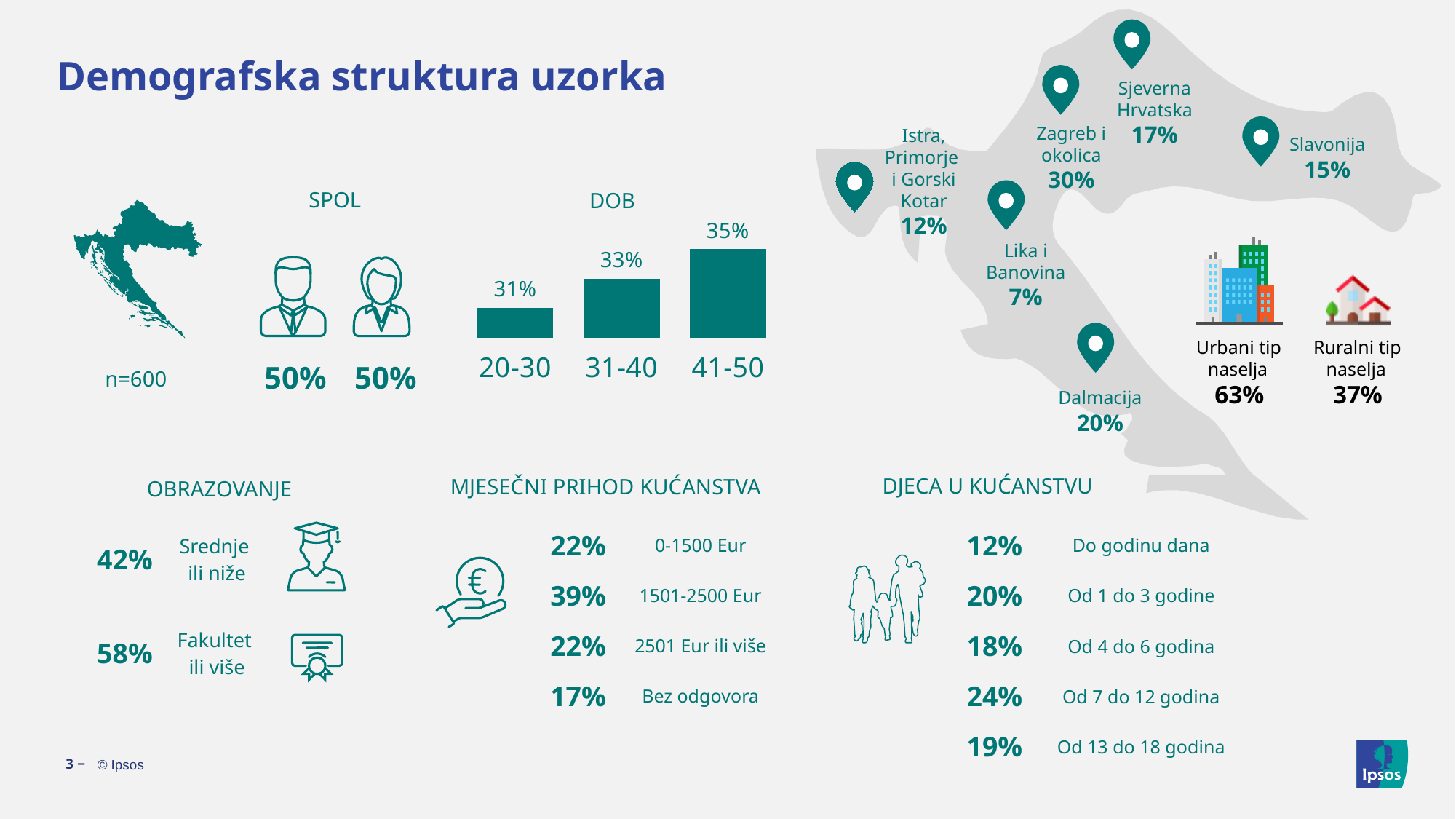
In the DOB bar chart, which age group has the lowest value? 20-30 What is the title of the bar chart on the slide? DOB In the DOB bar chart, which is larger: the value for 41-50 or the value for 31-40? 41-50 In the DOB bar chart, what is the value for the 20-30 age group? 31% In the DOB bar chart, which age group has the highest value? 41-50 How many age groups are shown in the DOB bar chart? 3 In the DOB bar chart, what is the value for the 41-50 age group? 35% What kind of chart is the DOB chart? bar chart In the DOB bar chart, do the values rise or fall from the 20-30 group to the 41-50 group? rise In the DOB bar chart, what is the difference between the values for 41-50 and 20-30? 4% In the DOB bar chart, what is the value for the 31-40 age group? 33% In the DOB bar chart, what is the difference between the values for 31-40 and 20-30? 2%